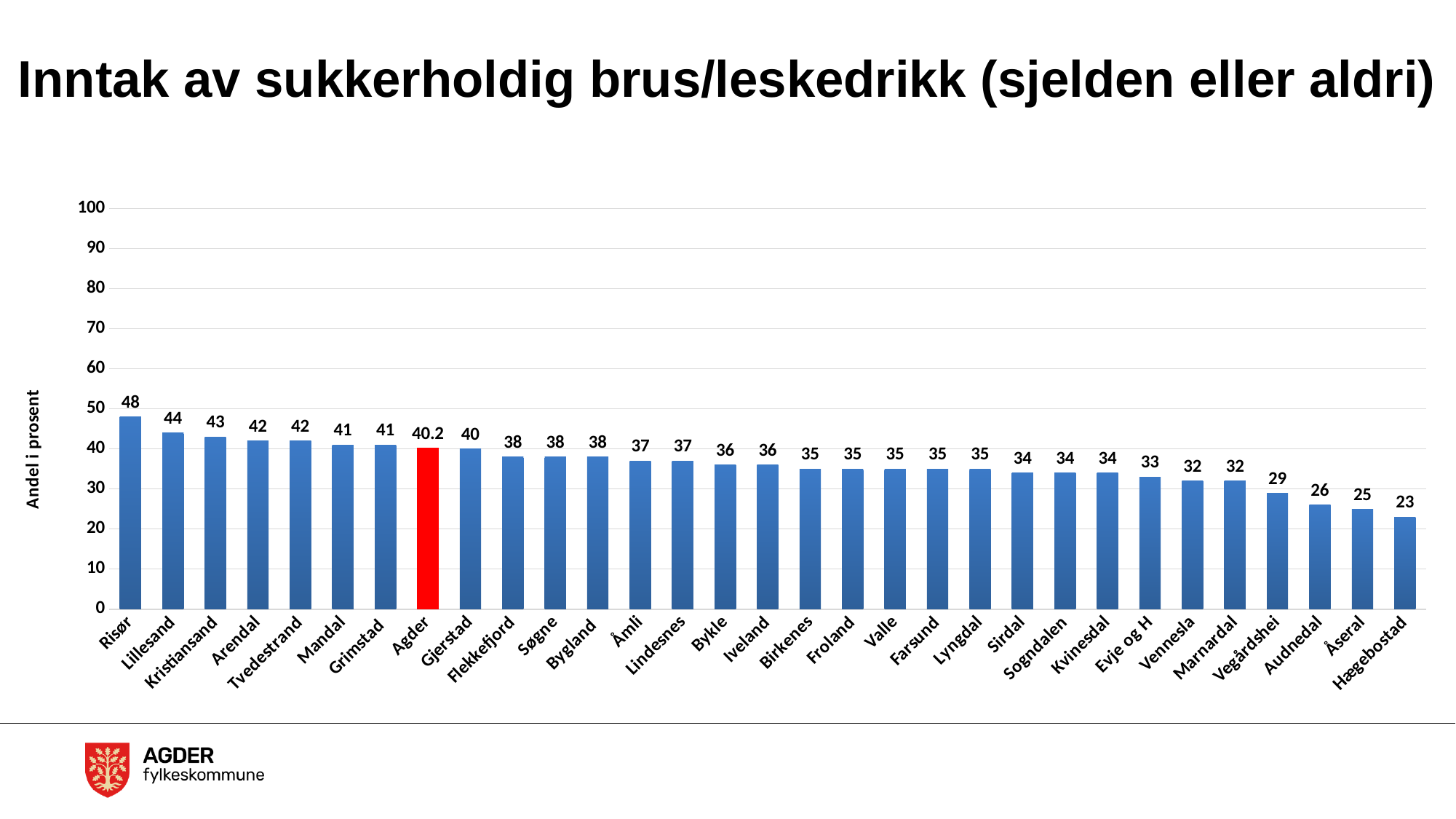
Which category has the lowest value? Hægebostad Which category has the highest value? Risør What is the value for Hægebostad? 23 What is the value for Agder? 40.2 How many categories are shown on the x axis? 31 What is the difference between the values for Risør and Hægebostad? 25 Which bar is coloured red instead of blue? Agder Which is larger, the value for Lillesand or the value for Vennesla? Lillesand Is the value for Vegårdshei greater or less than 30? less Do the values rise or fall from left to right along the x axis? fall What kind of chart is shown on the slide? bar chart What is the value for Risør? 48